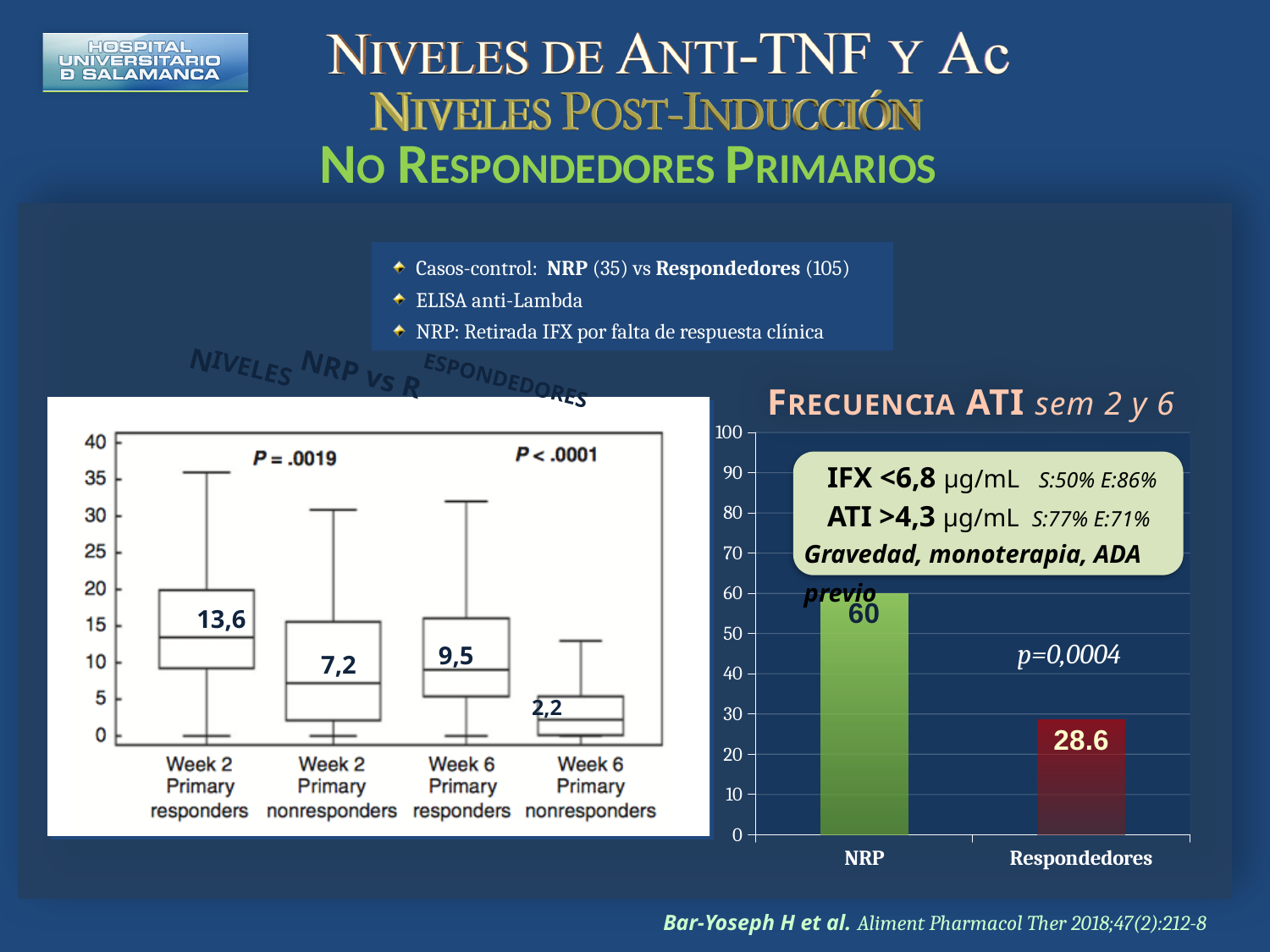
In the box plot on the left of the slide, which group has the lowest labelled median value? Week 6 Primary nonresponders In the bar chart titled 'Frecuencia ATI sem 2 y 6', which category has the higher value? NRP In the box plot on the left of the slide, which labelled median is larger: Week 2 Primary nonresponders or Week 6 Primary responders? Week 6 Primary responders In the box plot on the left of the slide, what median value is labelled for Week 6 Primary nonresponders? 2,2 In the bar chart titled 'Frecuencia ATI sem 2 y 6', how many categories are shown on the x axis? 2 What kind of chart is the one titled 'Frecuencia ATI sem 2 y 6' on the right of the slide? Bar chart In the bar chart titled 'Frecuencia ATI sem 2 y 6', is the value for Respondedores greater or less than 30? less In the box plot on the left of the slide, what median value is labelled for Week 2 Primary responders? 13,6 In the bar chart titled 'Frecuencia ATI sem 2 y 6', what is the value for NRP? 60 In the bar chart titled 'Frecuencia ATI sem 2 y 6', what p-value is printed on the chart? p=0,0004 In the bar chart titled 'Frecuencia ATI sem 2 y 6', what is the difference between the NRP value and the Respondedores value? 31.4 In the bar chart titled 'Frecuencia ATI sem 2 y 6', what is the value for Respondedores? 28.6